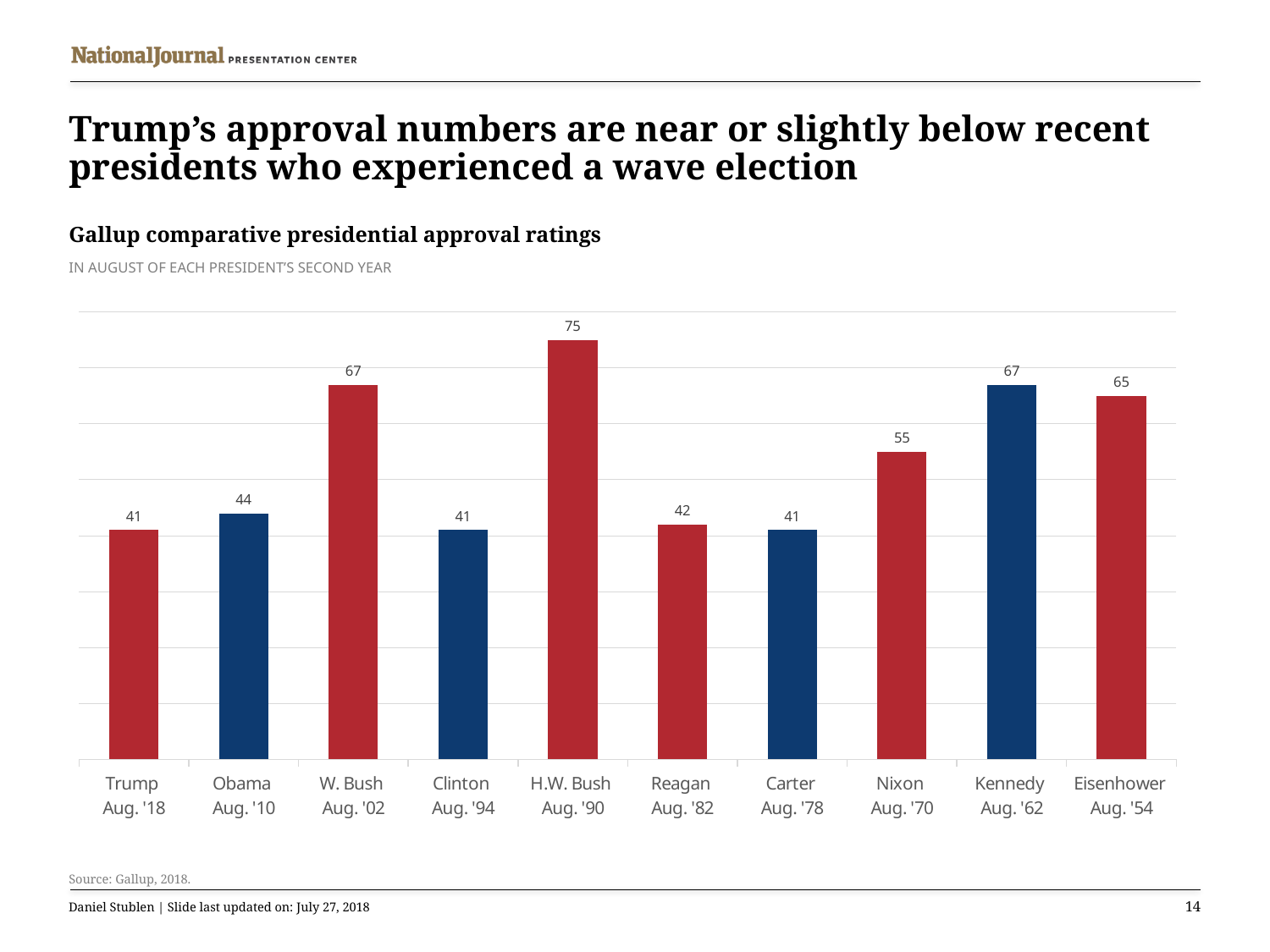
What kind of chart is shown on the slide? Bar chart What is the approval rating shown for Trump (Aug. '18)? 41 Which president has the highest approval rating on the chart? H.W. Bush What is the approval rating shown for Nixon (Aug. '70)? 55 How many presidents are shown on the chart? 10 What is the difference between Obama's approval rating and Clinton's? 3 What is the approval rating shown for Eisenhower (Aug. '54)? 65 Which is larger, the approval rating for Obama or for Carter? Obama Which is larger, the approval rating for Nixon or for Reagan? Nixon What is the source cited for the chart? Gallup, 2018. What is the title of the chart? Gallup comparative presidential approval ratings What is the difference between H.W. Bush's approval rating and Trump's? 34